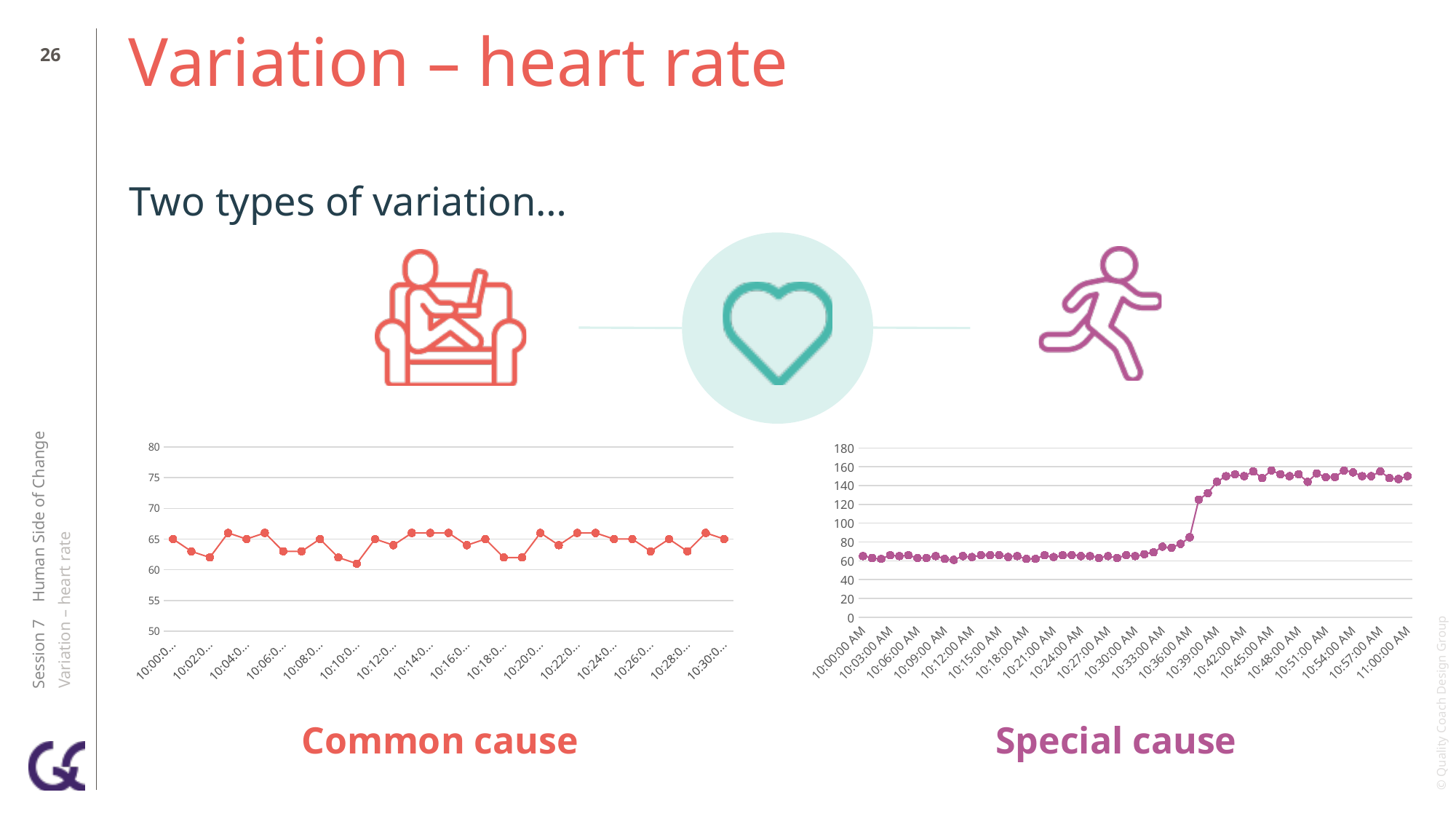
In the Special cause chart, is the value at 10:00:00 AM greater or less than 80? less What kind of chart is the Special cause chart on the right? line chart In the Special cause chart, is the value at 10:45:00 AM greater or less than 140? greater What is the highest value shown on the y axis of the Common cause chart? 80 In the Special cause chart, do the values overall rise or fall from 10:00:00 AM to 11:00:00 AM? rise How many time labels are shown on the x axis of the Special cause chart? 21 In the Special cause chart, is the value at 11:00:00 AM greater or less than 140? greater What kind of chart is the Common cause chart on the left? line chart What is the highest value shown on the y axis of the Special cause chart? 180